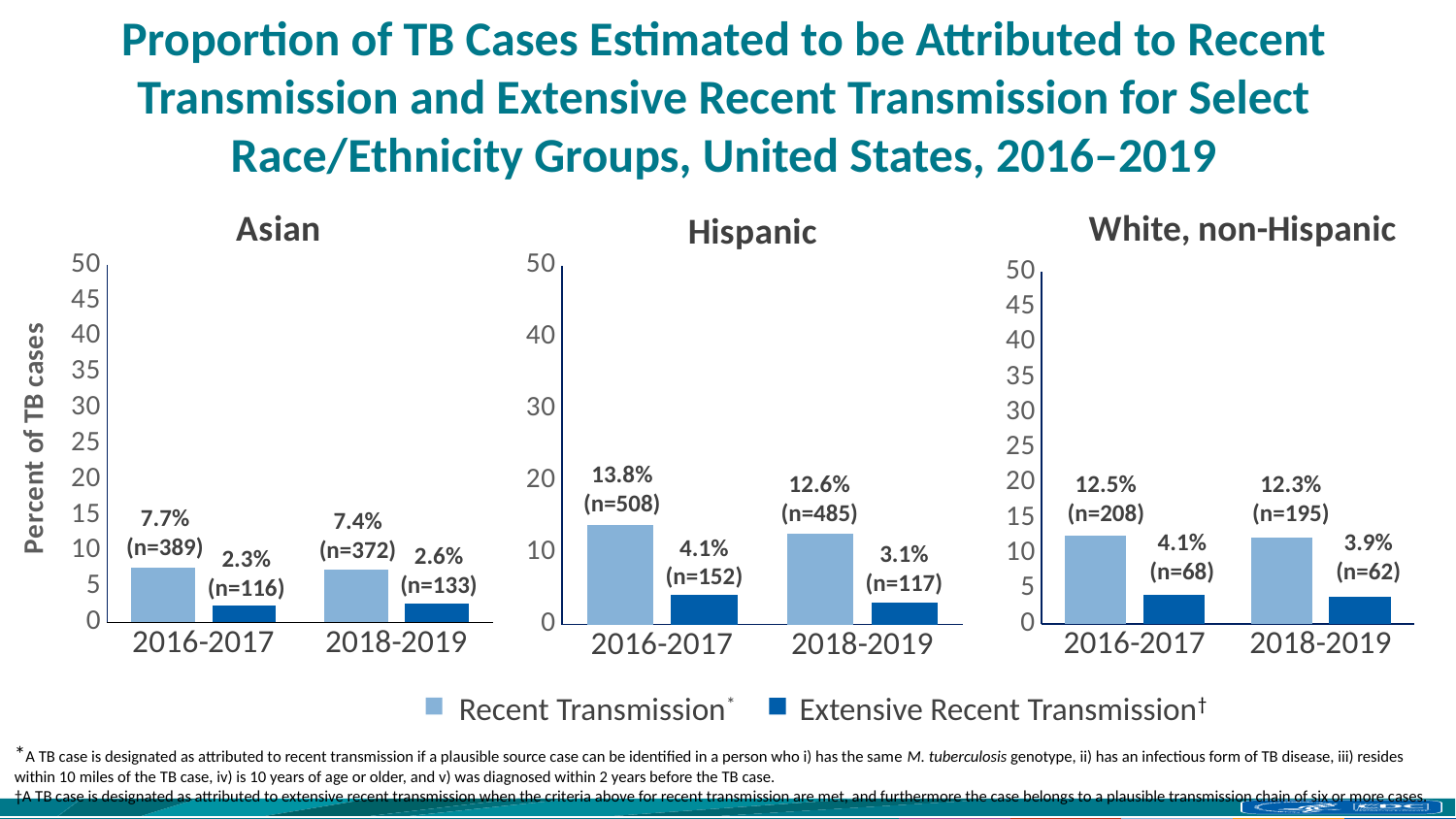
In the Asian chart, is the Recent Transmission value for 2016-2017 greater or less than 10? less How many series does the legend list? 2 In the Asian chart, what is the Recent Transmission value for 2016-2017? 7.7% In the Hispanic chart, does the Recent Transmission value rise or fall from 2016-2017 to 2018-2019? Fall Across the three charts, which race/ethnicity group has the highest Recent Transmission value in 2016-2017? Hispanic In the Hispanic chart, what is the Extensive Recent Transmission value for 2018-2019? 3.1% In the Asian chart, what is the difference between the Recent Transmission values for 2016-2017 and 2018-2019? 0.3% In the Hispanic chart, what is the difference between Recent Transmission and Extensive Recent Transmission in 2016-2017? 9.7% In the White, non-Hispanic chart, which is larger: Extensive Recent Transmission in 2016-2017 or in 2018-2019? 2016-2017 In the Hispanic chart, what is the number of cases (n) for Recent Transmission in 2016-2017? n=508 In the White, non-Hispanic chart, what is the Recent Transmission value for 2018-2019? 12.3% What kind of chart is used for the Hispanic group? Bar chart